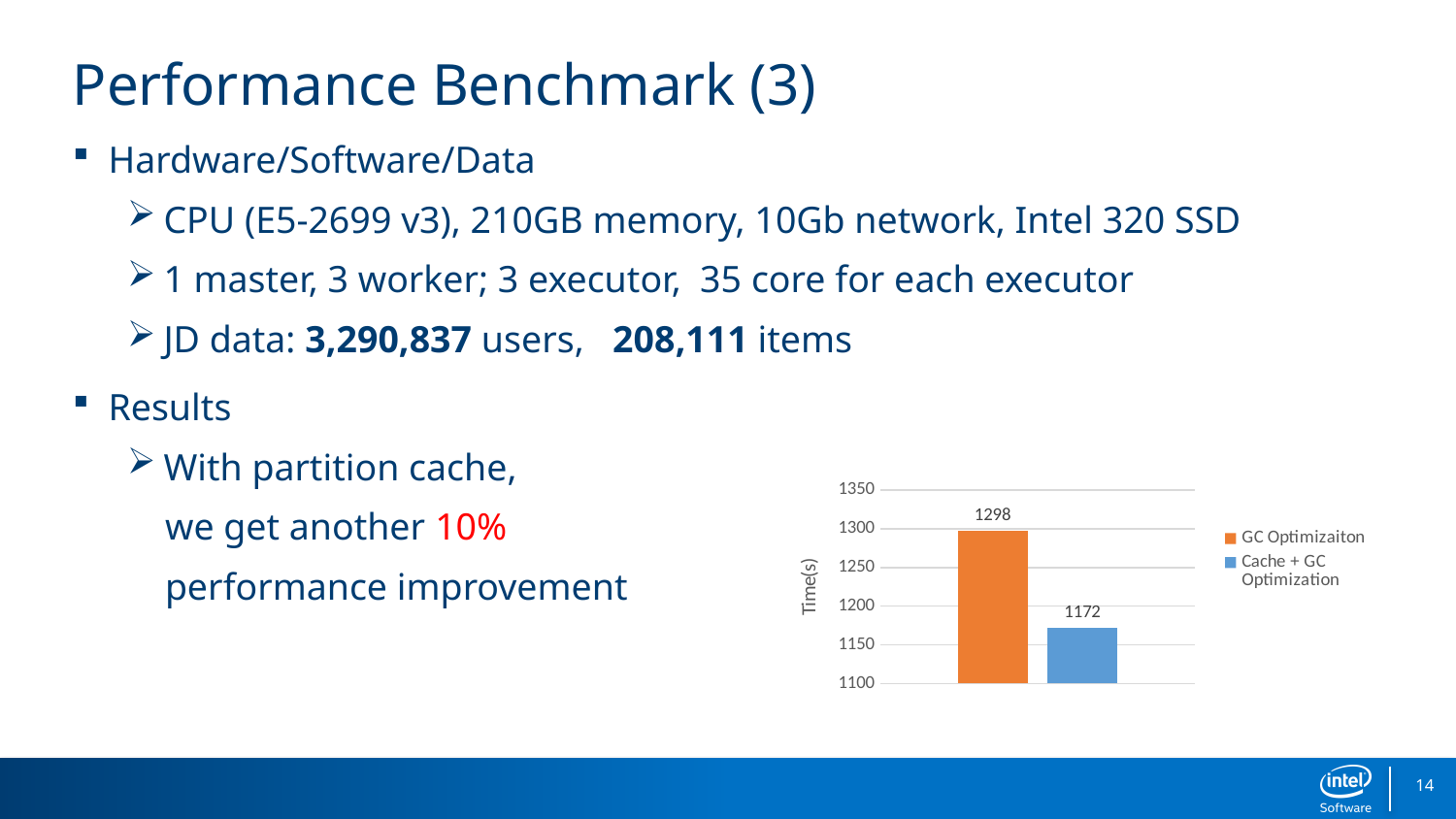
What kind of chart is shown on the slide? bar chart Which series has the lowest time? Cache + GC Optimization What is the label of the vertical axis of the chart? Time(s) Is the value for Cache + GC Optimization greater or less than 1200? less What is the time for GC Optimizaiton? 1298 Is the value for GC Optimizaiton greater or less than 1250? greater Which is larger, the time for GC Optimizaiton or for Cache + GC Optimization? GC Optimizaiton What is the difference in time between GC Optimizaiton and Cache + GC Optimization? 126 What is the time for Cache + GC Optimization? 1172 Which series has the highest time? GC Optimizaiton How many series does the legend list? 2 How many bars are plotted in the chart? 2